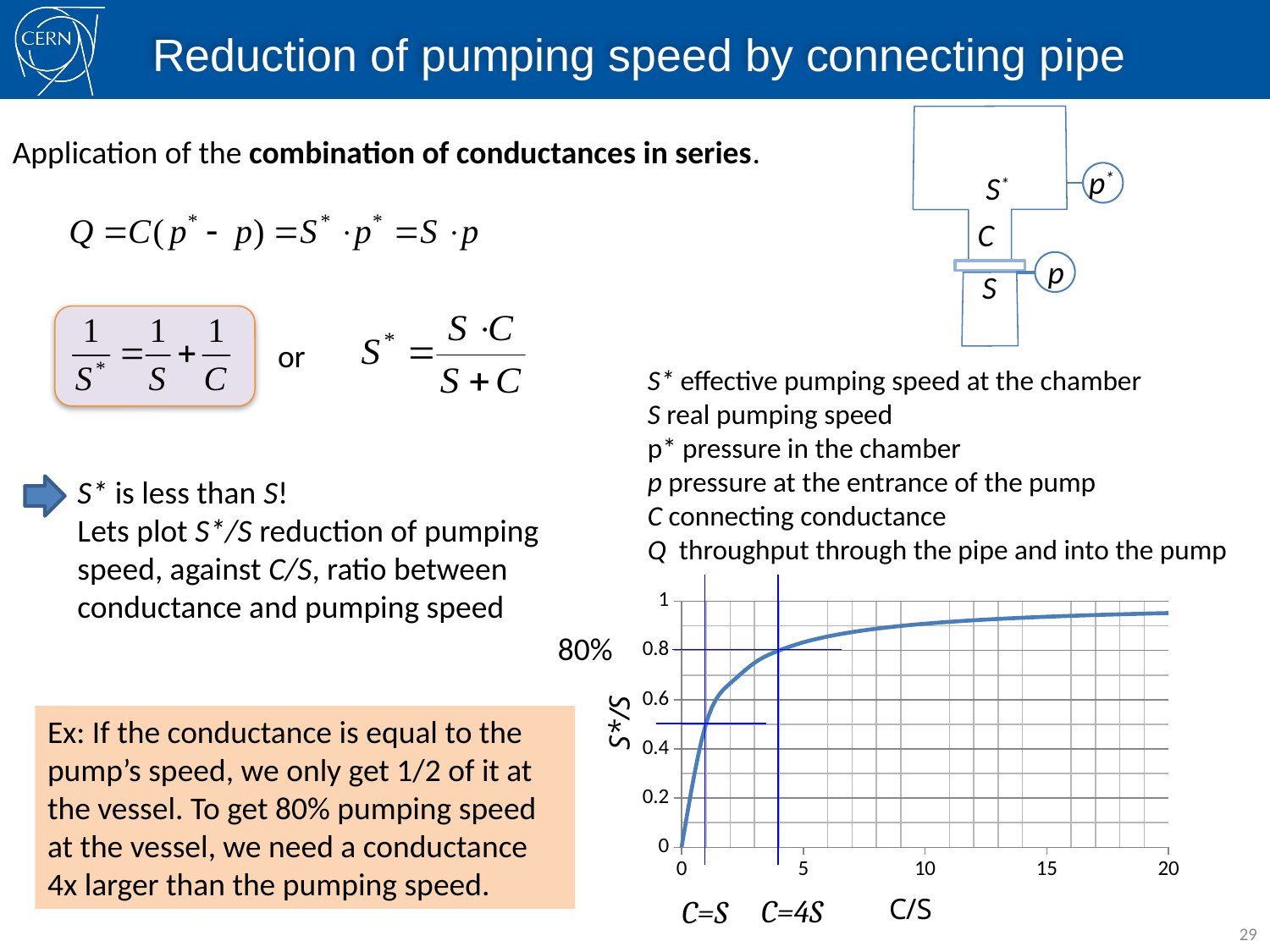
Is the value of S*/S at C/S = 10 greater or less than 0.8? greater What is the label of the x axis of the chart? C/S Is the value of S*/S at C/S = 1 greater or less than 0.6? less What is the label of the y axis of the chart? S*/S Does the plotted S*/S curve rise or fall as C/S increases along the x axis? rise Which has the larger S*/S value on the chart: C/S = 5 or C/S = 15? C/S = 15 Is the value of S*/S at C/S = 20 greater or less than 1? less According to the chart annotation, what is the value of S*/S at C=4S? 0.8 What type of chart is shown at the bottom right of the slide? line chart